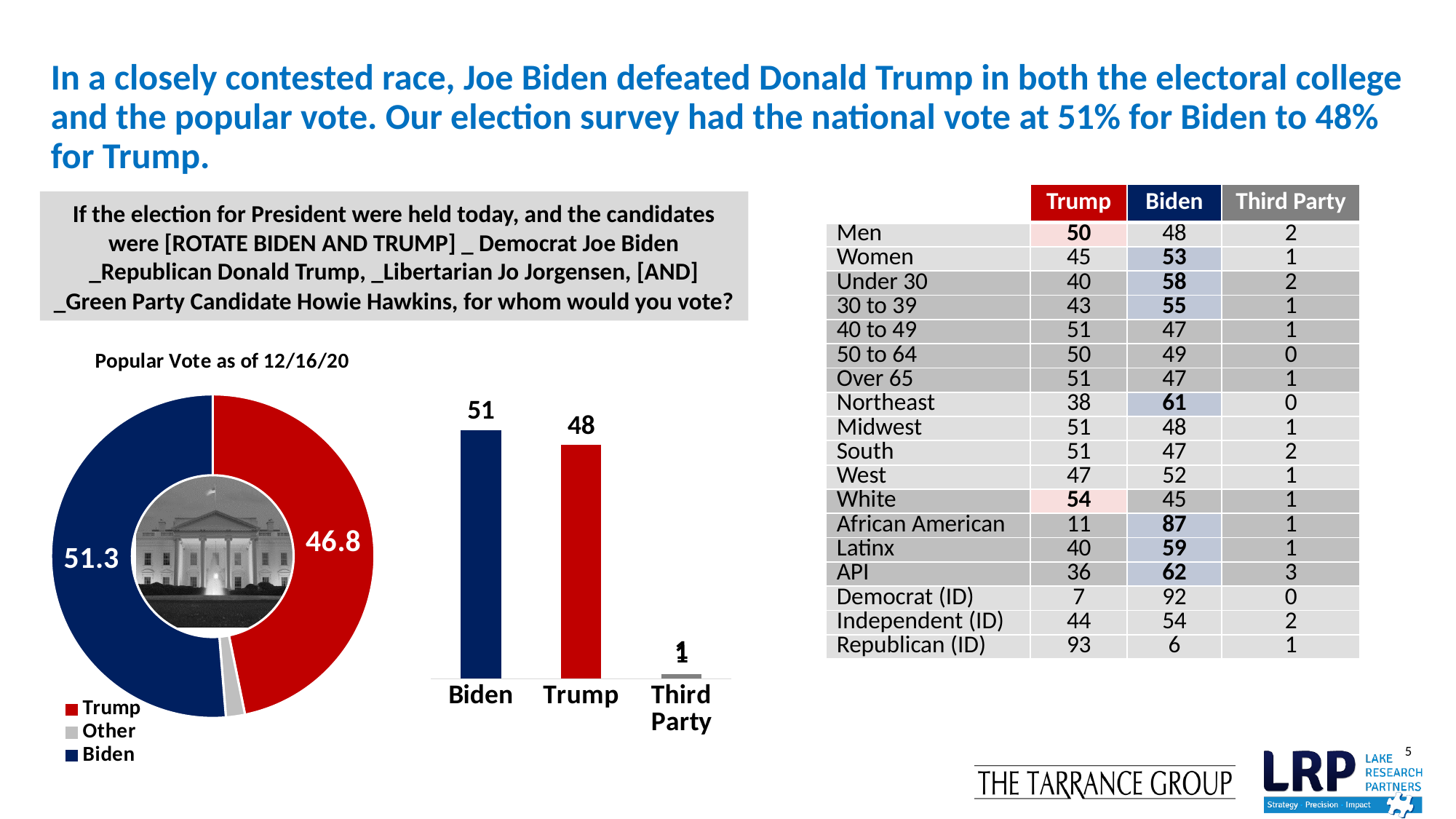
In the bar chart in the middle of the slide, what is the value for Biden? 51 In the doughnut chart titled 'Popular Vote as of 12/16/20', what is the value shown for Biden? 51.3 In the bar chart in the middle of the slide, what is the difference between the Biden and Trump values? 3 In the bar chart in the middle of the slide, which category has the highest value? Biden What is the title of the doughnut chart on the left of the slide? Popular Vote as of 12/16/20 In the bar chart in the middle of the slide, what is the value for Third Party? 1 In the doughnut chart titled 'Popular Vote as of 12/16/20', what is the value shown for Trump? 46.8 How many entries does the legend of the doughnut chart titled 'Popular Vote as of 12/16/20' list? 3 In the doughnut chart titled 'Popular Vote as of 12/16/20', what is the difference between the Biden and Trump values? 4.5 What kind of chart is the chart in the middle of the slide showing Biden, Trump and Third Party? Bar chart In the doughnut chart titled 'Popular Vote as of 12/16/20', which candidate has the larger share, Trump or Biden? Biden In the bar chart in the middle of the slide, what is the value for Trump? 48